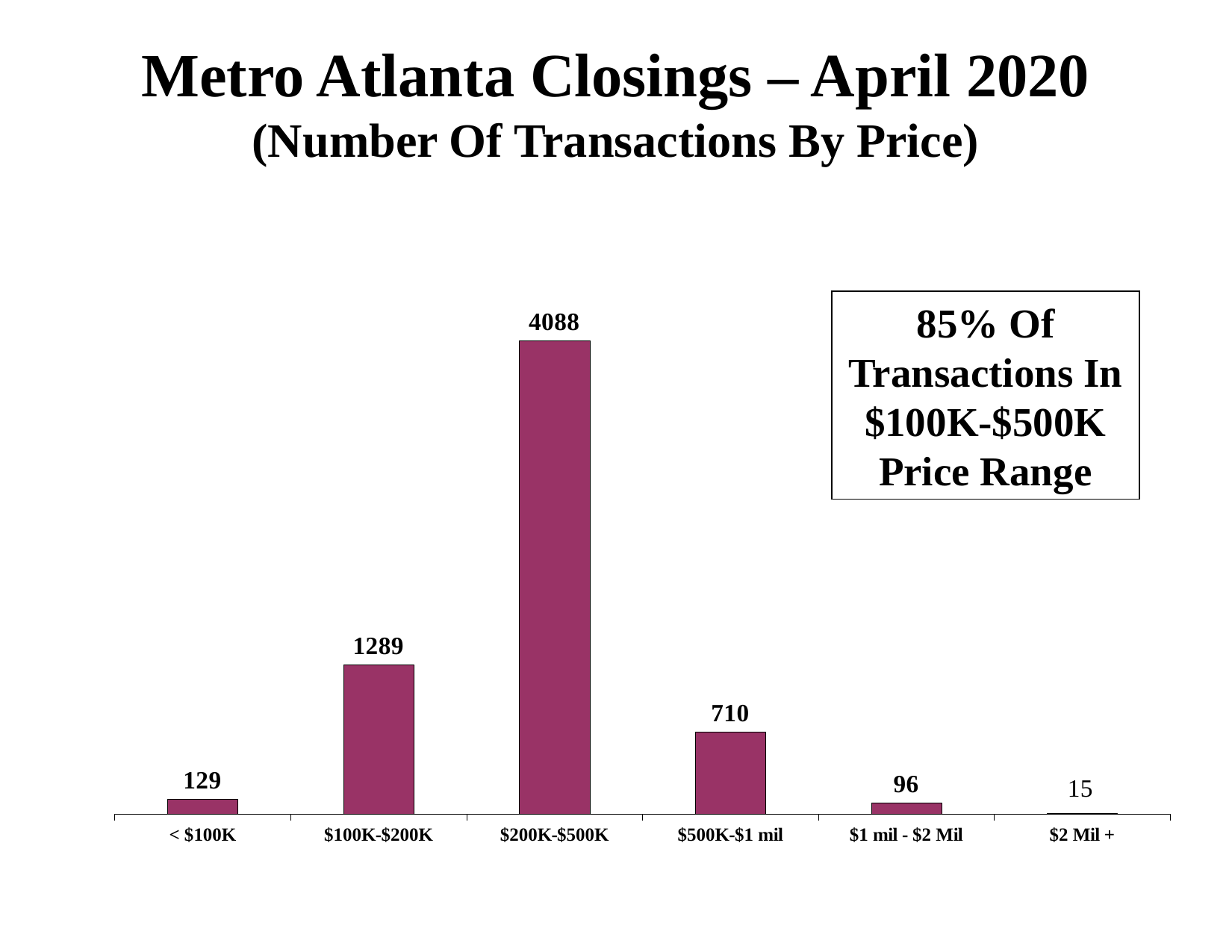
How many price range categories are shown on the chart? 6 What is the difference between the < $100K and $1 mil - $2 Mil values? 33 What is the value for the $1 mil - $2 Mil category? 96 Which is larger, the value for $500K-$1 mil or the value for < $100K? $500K-$1 mil According to the text box on the slide, what percentage of transactions were in the $100K-$500K price range? 85% What kind of chart is shown on the slide? Bar chart How many transactions were in the $2 Mil + category? 15 Which price range has the highest number of transactions? $200K-$500K How many transactions were in the $200K-$500K price range? 4088 What is the difference between the $200K-$500K and $100K-$200K values? 2799 Which price range has the lowest number of transactions? $2 Mil + What is the value for the $100K-$200K category? 1289